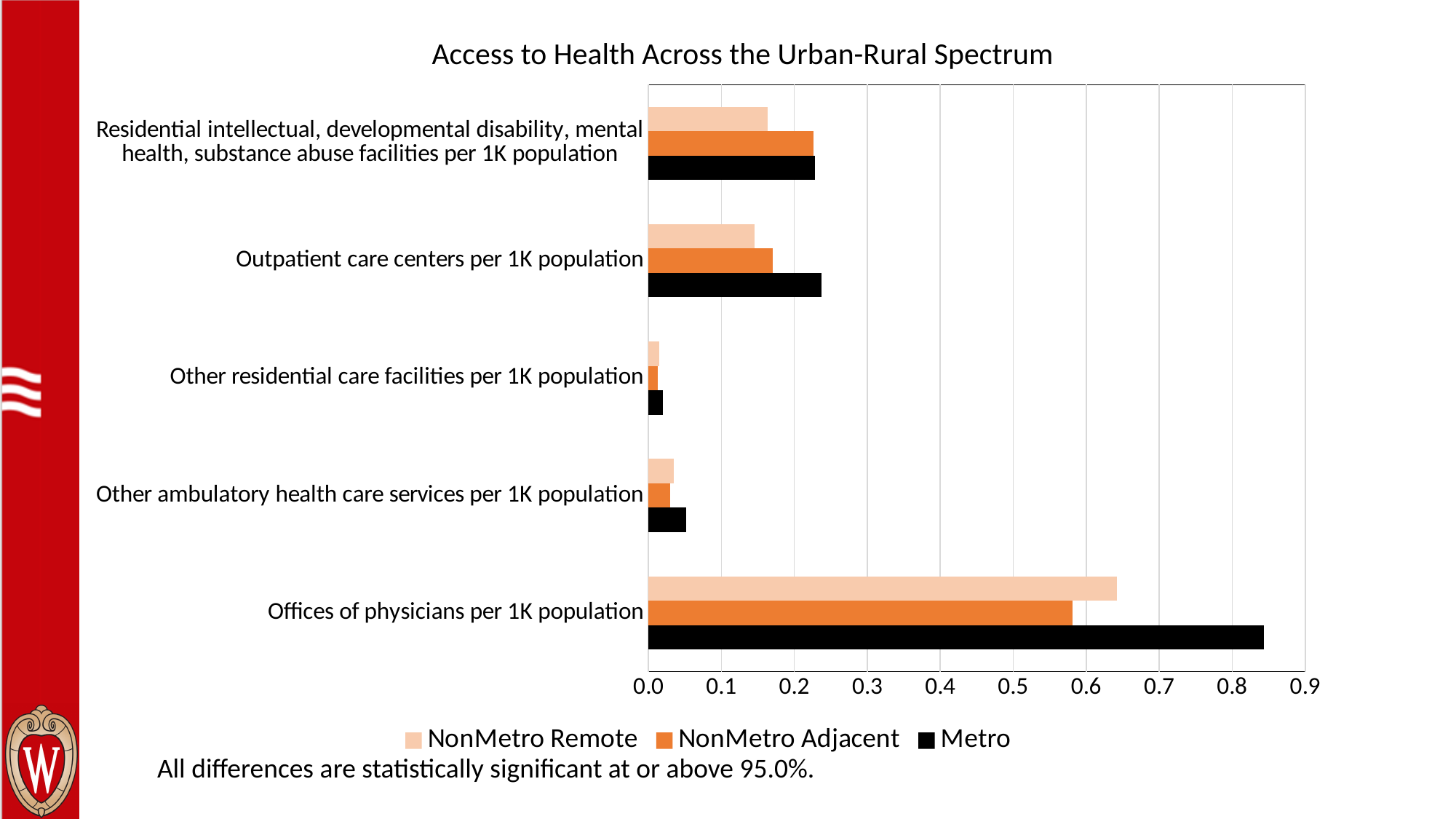
Which category has the highest Metro value? Offices of physicians per 1K population Is the NonMetro Adjacent value for Offices of physicians per 1K population greater or less than 0.6? less What kind of chart is shown on the slide? Bar chart For Outpatient care centers per 1K population, which is larger: the Metro value or the NonMetro Remote value? Metro Which category has the lowest Metro value? Other residential care facilities per 1K population Is the Metro value for Outpatient care centers per 1K population greater or less than 0.2? greater For Offices of physicians per 1K population, which is larger: the Metro value or the NonMetro Remote value? Metro What is the title of the chart? Access to Health Across the Urban-Rural Spectrum How many series does the legend list? 3 Is the Metro value for Offices of physicians per 1K population greater or less than 0.8? greater How many categories are plotted on the chart? 5